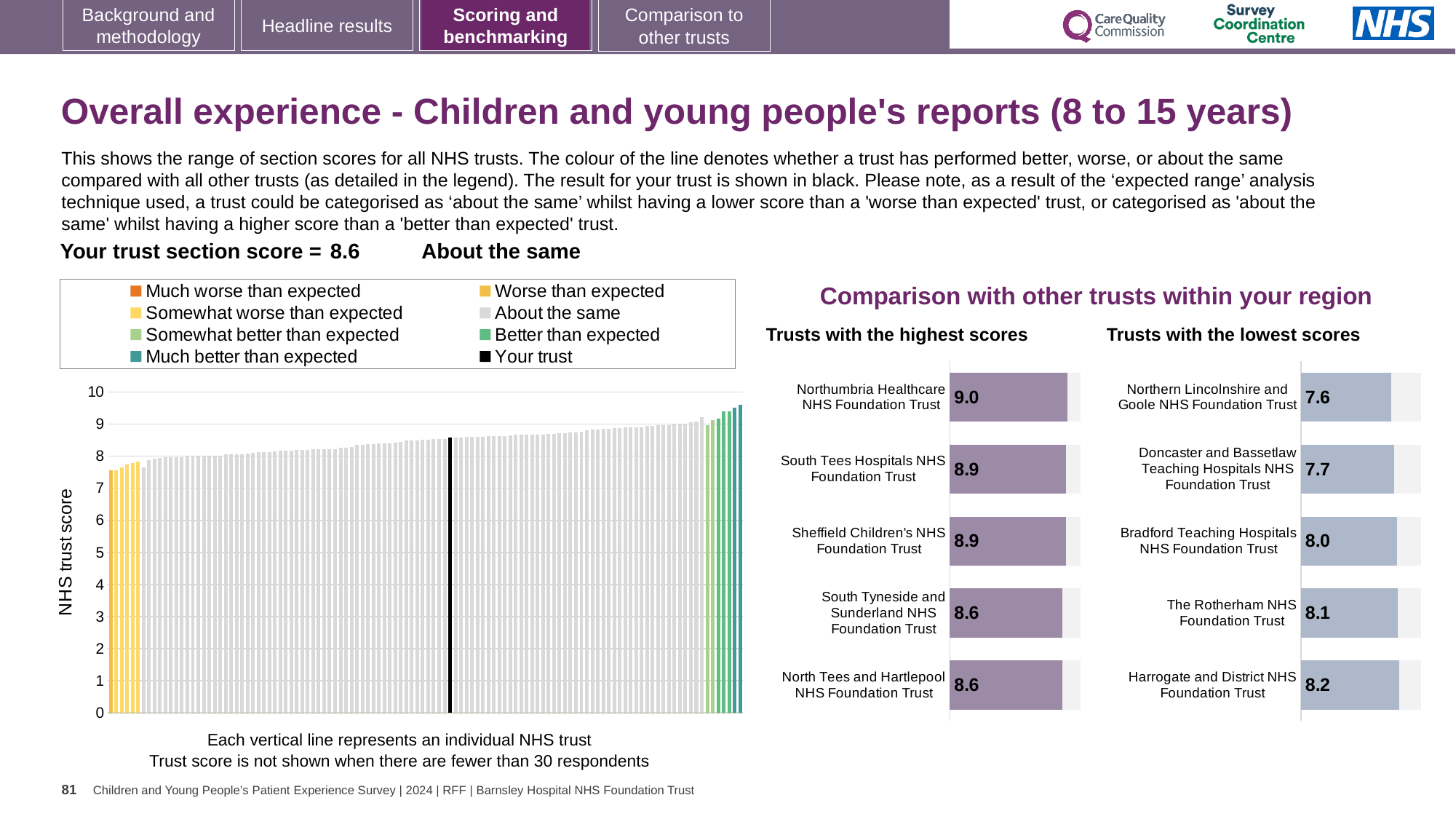
In the 'Trusts with the highest scores' chart, how many trusts are shown? 5 How many entries does the legend above the large chart on the left list? 8 In the large chart on the left, is the value of the black bar (your trust) greater or less than 8? greater In the large chart on the left, do the trust scores rise or fall from left to right? rise In the large chart on the left, what is the label on the vertical axis? NHS trust score In the 'Trusts with the highest scores' chart, what is the score for Northumbria Healthcare NHS Foundation Trust? 9.0 In the 'Trusts with the lowest scores' chart, which trust has the lowest score? Northern Lincolnshire and Goole NHS Foundation Trust In the 'Trusts with the highest scores' chart, what is the difference between the scores of Northumbria Healthcare NHS Foundation Trust and North Tees and Hartlepool NHS Foundation Trust? 0.4 In the 'Trusts with the lowest scores' chart, which has the larger score: Bradford Teaching Hospitals NHS Foundation Trust or Harrogate and District NHS Foundation Trust? Harrogate and District NHS Foundation Trust What type of chart is the large chart on the left showing the range of section scores for all NHS trusts? bar chart In the 'Trusts with the highest scores' chart, which trust has the highest score? Northumbria Healthcare NHS Foundation Trust In the 'Trusts with the lowest scores' chart, what is the score for Doncaster and Bassetlaw Teaching Hospitals NHS Foundation Trust? 7.7